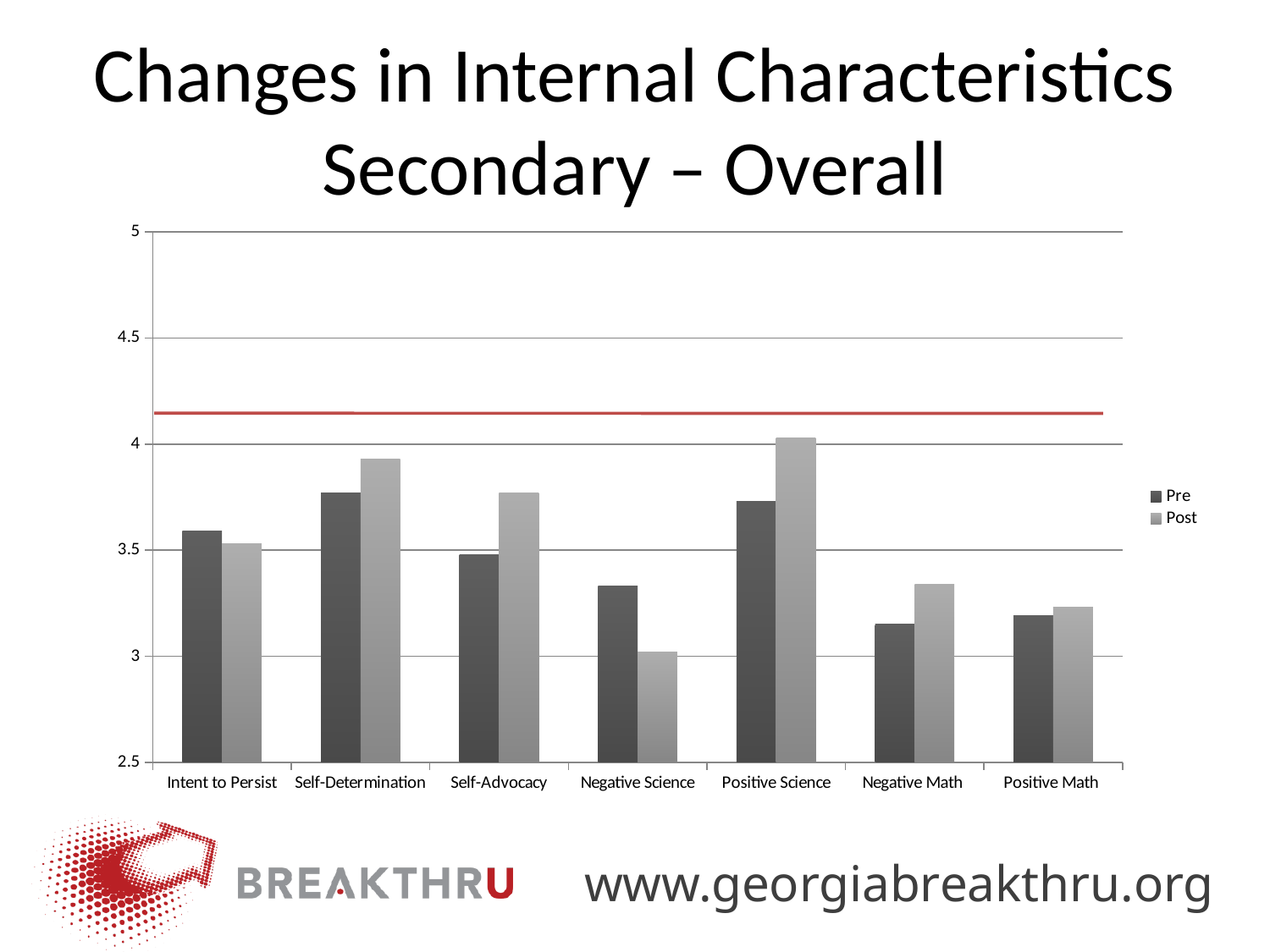
Is the Post value for Self-Determination greater or less than 4? less Which category has the lowest Post value? Negative Science What are the two series named in the legend? Pre and Post Which category has the highest Post value? Positive Science For Negative Science, which is larger, the Pre value or the Post value? Pre What kind of chart is shown on the slide? bar chart For Self-Advocacy, which is larger, the Pre value or the Post value? Post How many categories are shown along the x axis? 7 Is the Pre value for Negative Science greater or less than 3.5? less How many series does the legend list? 2 Is the Pre value for Intent to Persist greater or less than 3.5? greater